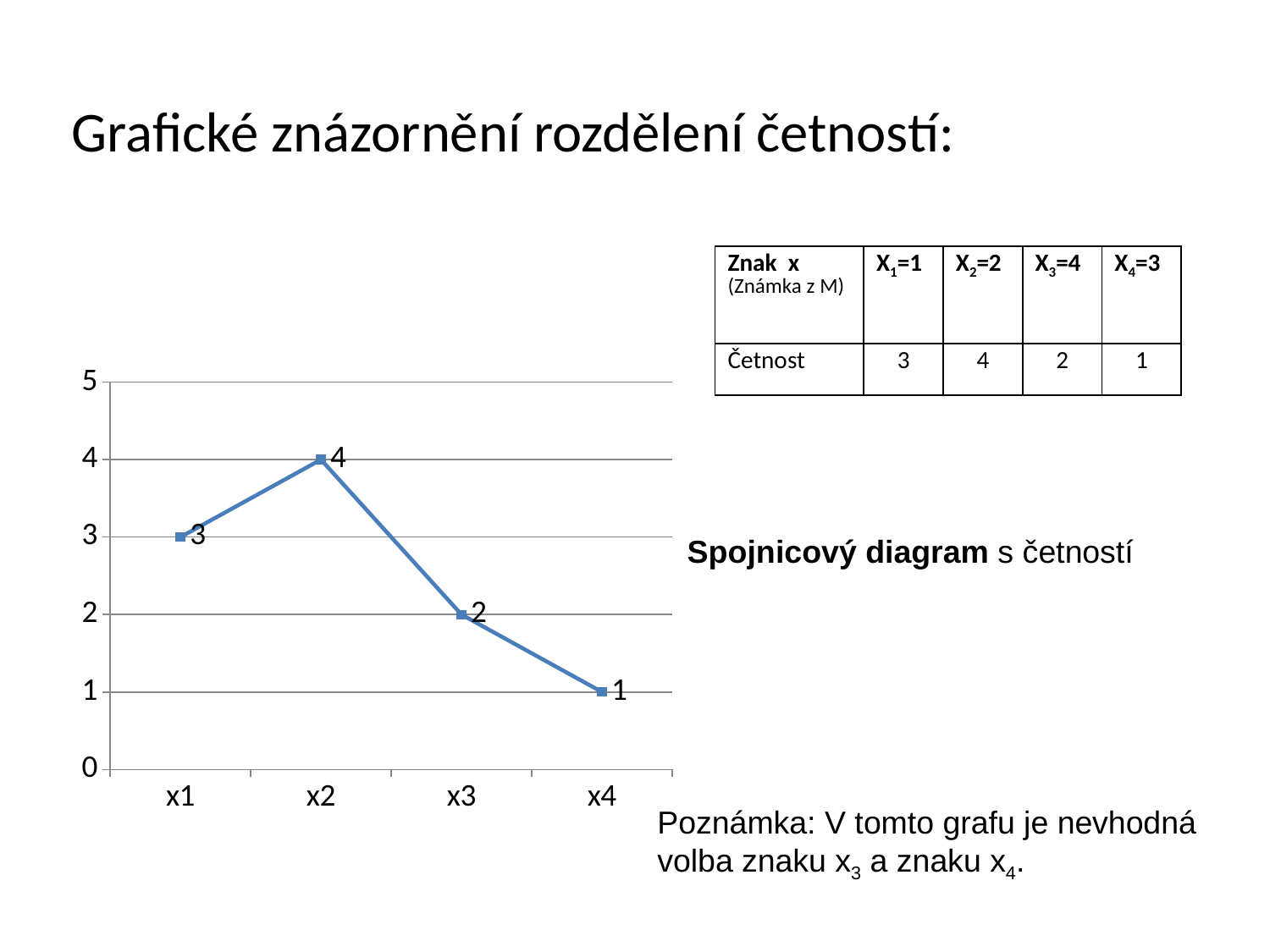
Do the values rise or fall from x2 to x4? fall What is the difference between the values for x2 and x4? 3 Which category has the highest value? x2 How many categories are plotted on the x axis? 4 What kind of chart is shown on the slide? line chart What is the maximum value shown on the y axis? 5 Which category has the lowest value? x4 Which has a larger value, x1 or x3? x1 What is the value plotted for x3? 2 What is the value plotted for x1? 3 What is the value plotted for x2? 4 What is the value plotted for x4? 1